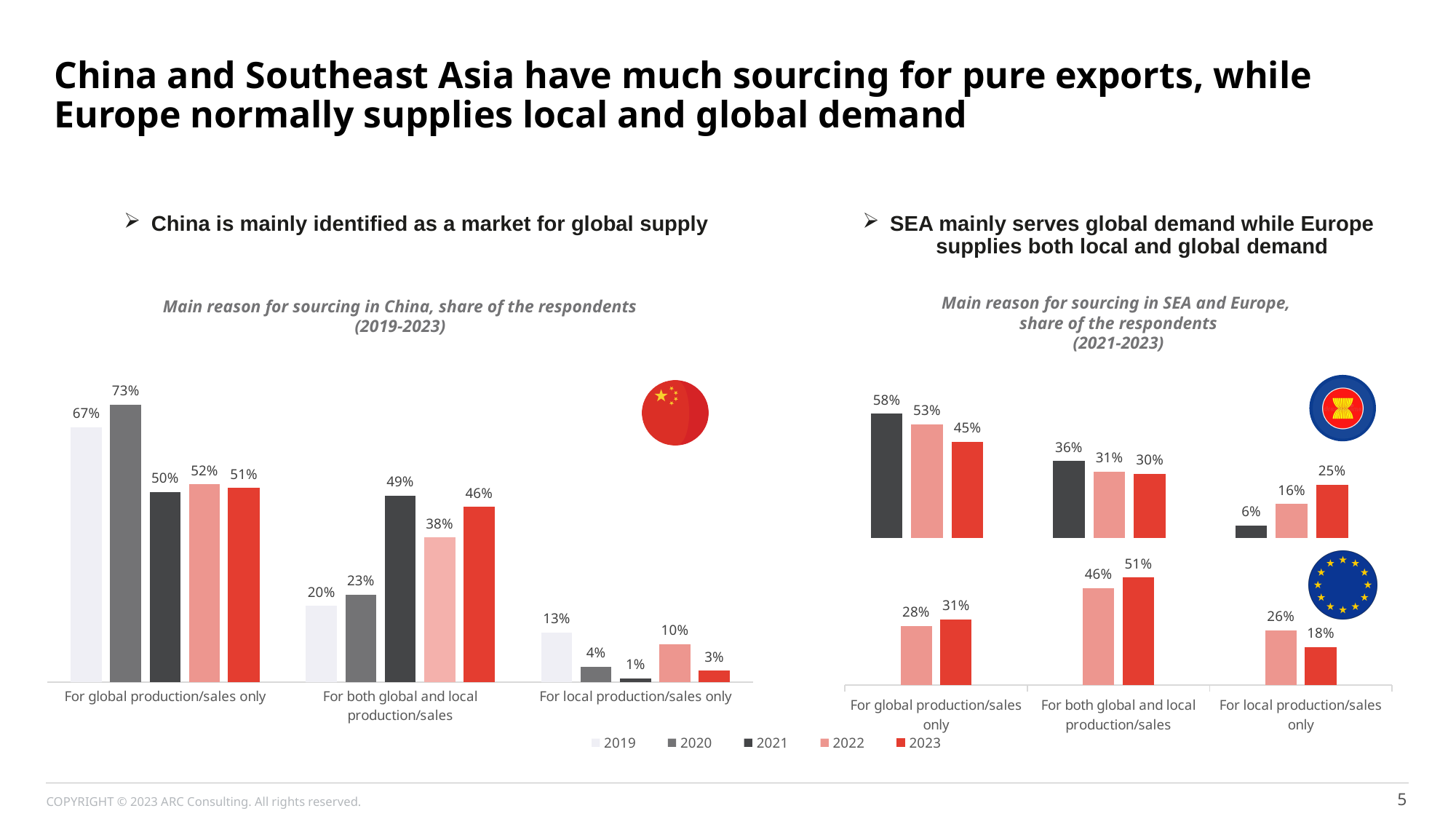
In the chart 'Main reason for sourcing in China', what is the 2023 value for 'For both global and local production/sales'? 46% How many categories are shown on the x axis of the chart 'Main reason for sourcing in China'? 3 In the chart 'Main reason for sourcing in China', what is the difference between the 2019 and 2020 values for 'For global production/sales only'? 6% In the chart 'Main reason for sourcing in China', which is larger for 2022: 'For global production/sales only' or 'For both global and local production/sales'? For global production/sales only In the chart 'Main reason for sourcing in China', which year has the lowest value for 'For local production/sales only'? 2021 In the chart 'Main reason for sourcing in SEA and Europe', what is the SEA value for 'For local production/sales only' in 2023? 25% In the chart 'Main reason for sourcing in SEA and Europe', how do the SEA values for 'For global production/sales only' change from 2021 to 2023? They fall In the chart 'Main reason for sourcing in SEA and Europe', what is the difference between the Europe values for 'For local production/sales only' in 2022 and 2023? 8% In the chart 'Main reason for sourcing in China', what share of respondents chose 'For global production/sales only' in 2020? 73% In the chart 'Main reason for sourcing in SEA and Europe', what is the Europe value for 'For both global and local production/sales' in 2023? 51% What type of chart is 'Main reason for sourcing in China, share of the respondents'? Bar chart How many series does the legend at the bottom of the slide list? 5